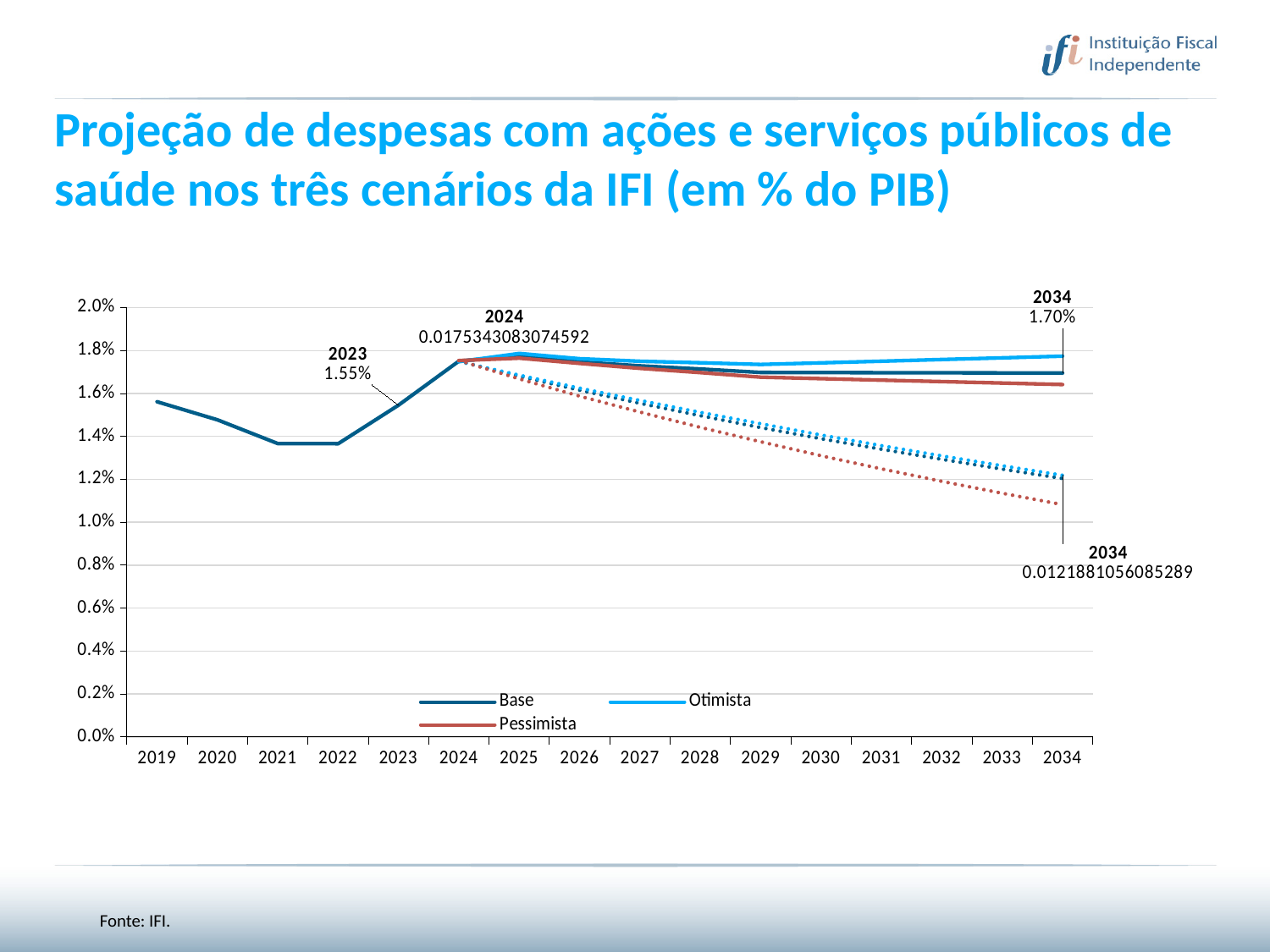
Do the values rise or fall from 2019 to 2021? fall Which is larger, the labelled value for 2023 or for 2024? 2024 What kind of chart is shown on the slide? line chart Is the value for 2019 greater or less than 1.4%? greater What value is labelled for 2024? 0.0175343083074592 What are the names of the series listed in the legend? Base, Otimista, Pessimista How many series does the legend list? 3 What value is labelled for 2023? 1.55% What value is labelled for 2034 on the dotted line? 0.0121881056085289 In 2034, which solid line is higher, Otimista or Pessimista? Otimista What value is labelled for the Base series in 2034 on the solid line? 1.70% How many years are shown on the x axis? 16